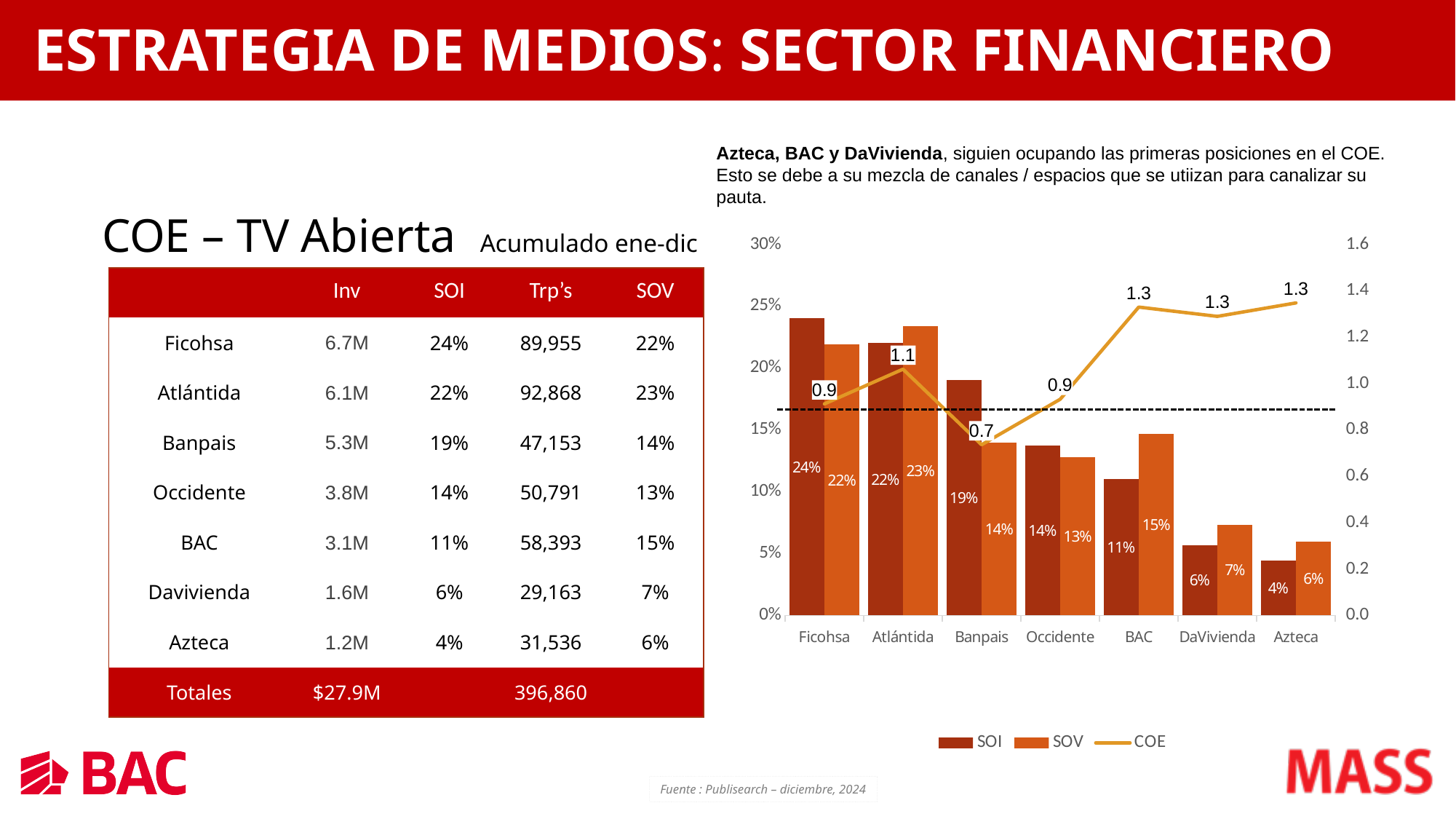
How many categories are shown on the x axis of the chart? 7 What is the SOV value for BAC? 15% Which category has the highest SOI? Ficohsa Which category has the lowest COE value on the line? Banpais How many series does the chart legend list? 3 Which is larger, the SOV of Atlántida or the SOV of Ficohsa? Atlántida Do the SOI values rise or fall from Ficohsa to Azteca along the x axis? Fall Which category has the lowest SOI? Azteca What is the SOI value for Banpais? 19% What is the COE value for Atlántida? 1.1 What kind of chart is shown on the slide? Combined bar and line chart What is the difference between the SOI of Ficohsa and the SOI of Azteca? 20 percentage points